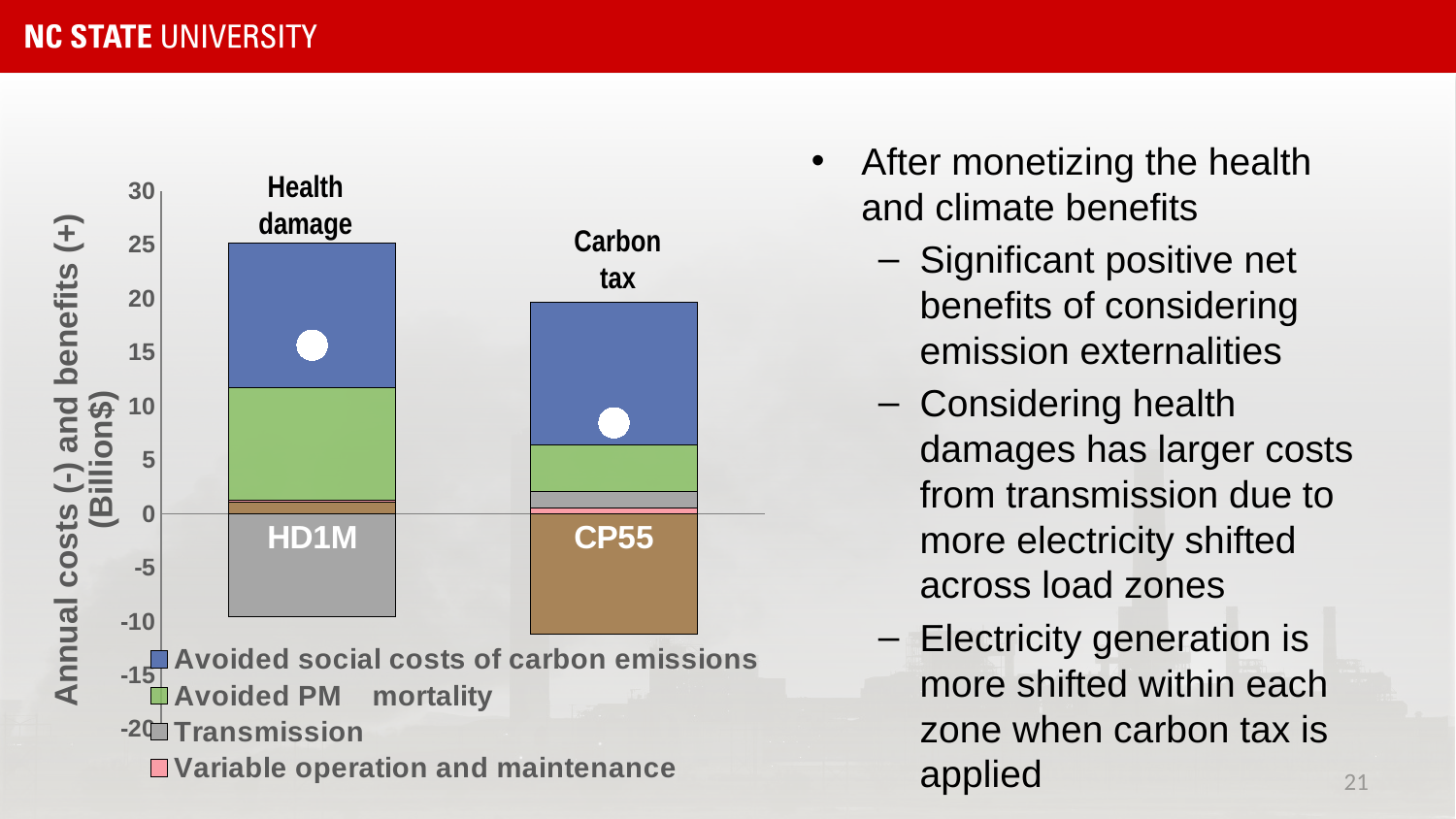
Is the bottom of the CP55 bar greater or less than -5? less How many series does the chart's legend list? 4 Which scenario has the larger 'Avoided PM mortality' (green) segment, HD1M or CP55? HD1M Is the top of the HD1M bar greater or less than 20? greater What label appears above the HD1M bar? Health damage What kind of chart is shown on the slide? Stacked bar chart What is the title of the vertical axis? Annual costs (-) and benefits (+) (Billion$) Which scenario's stacked bar reaches a higher positive value, HD1M or CP55? HD1M How many bars (scenarios) are plotted in the chart? 2 Is the top of the CP55 bar greater or less than 15? greater Which scenario has the larger 'Transmission' (gray) segment, HD1M or CP55? HD1M